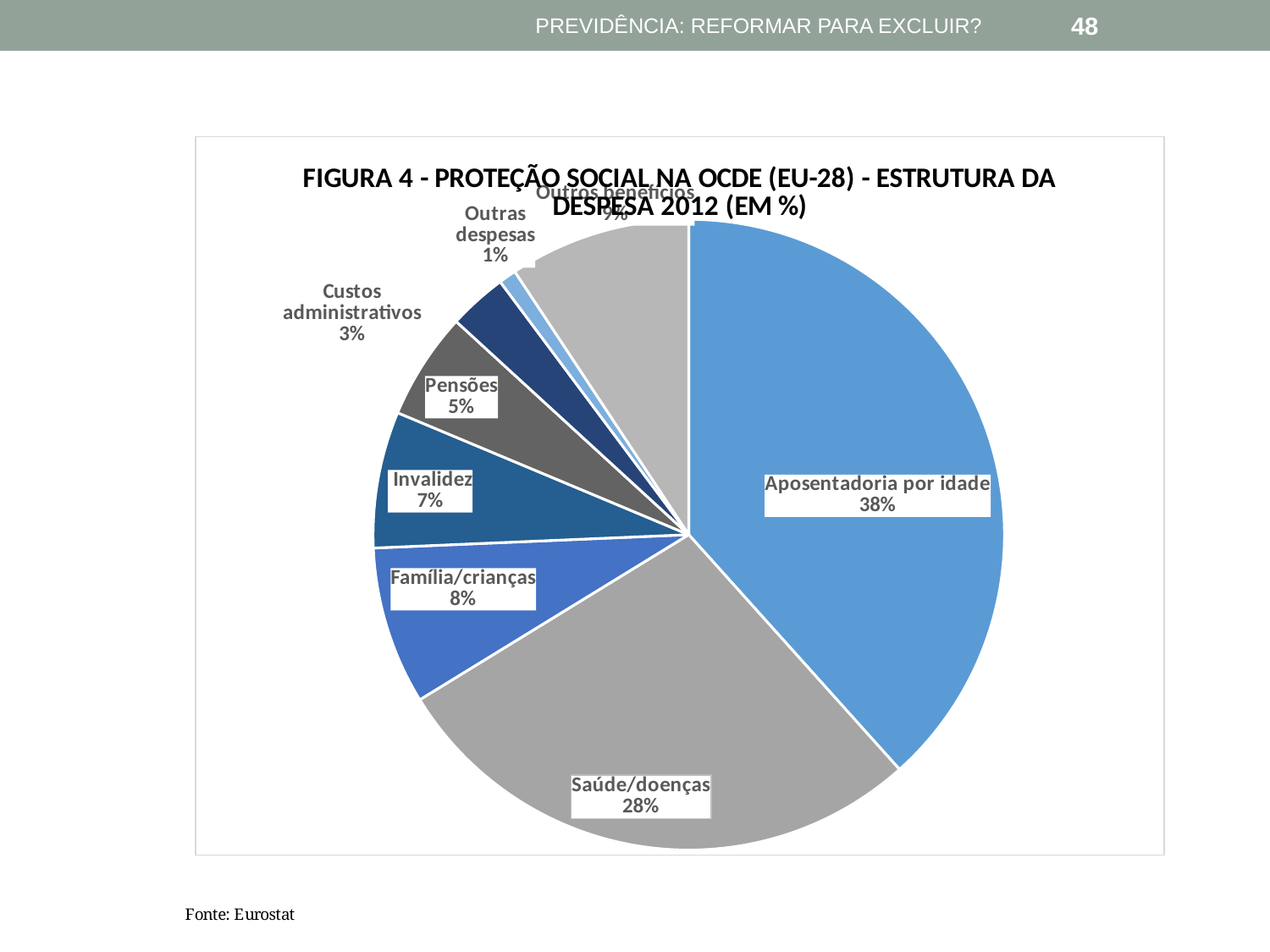
Which category has the largest slice of the pie? Aposentadoria por idade How many slices does the pie chart have? 8 Which is larger, the slice for Invalidez or the slice for Pensões? Invalidez What percentage is shown for Custos administrativos? 3% What is the value for Invalidez? 7% What percentage is shown for Família/crianças? 8% What is the value shown for Saúde/doenças? 28% What source is cited below the chart? Eurostat What kind of chart is shown on the slide? pie chart What is the difference in percentage points between Aposentadoria por idade and Saúde/doenças? 10 Which category has the smallest slice of the pie? Outras despesas What share of expenditure does Aposentadoria por idade account for? 38%